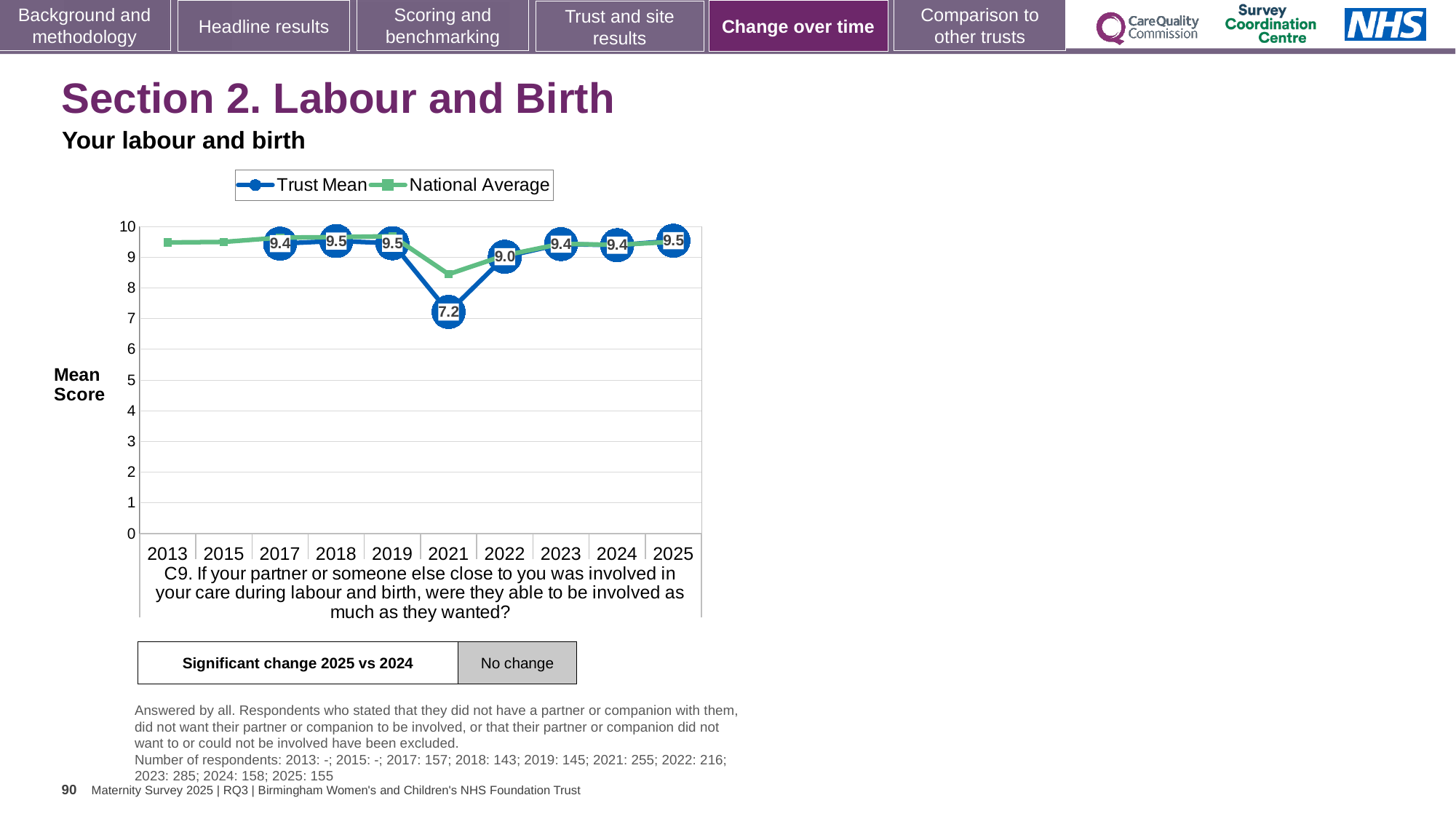
How many series does the legend list? 2 Which year has the higher Trust Mean, 2022 or 2023? 2023 What is the Trust Mean value for 2021? 7.2 What is the difference between the Trust Mean in 2022 and in 2021? 1.8 In which year is the Trust Mean lowest? 2021 Is the National Average value for 2021 greater or less than 8? greater How many years are shown on the x axis? 10 What is the Trust Mean value for 2017? 9.4 What is the difference between the Trust Mean in 2025 and in 2024? 0.1 What kind of chart is shown on the slide? line chart Does the Trust Mean rise or fall from 2021 to 2022? rise What is the Trust Mean value for 2025? 9.5